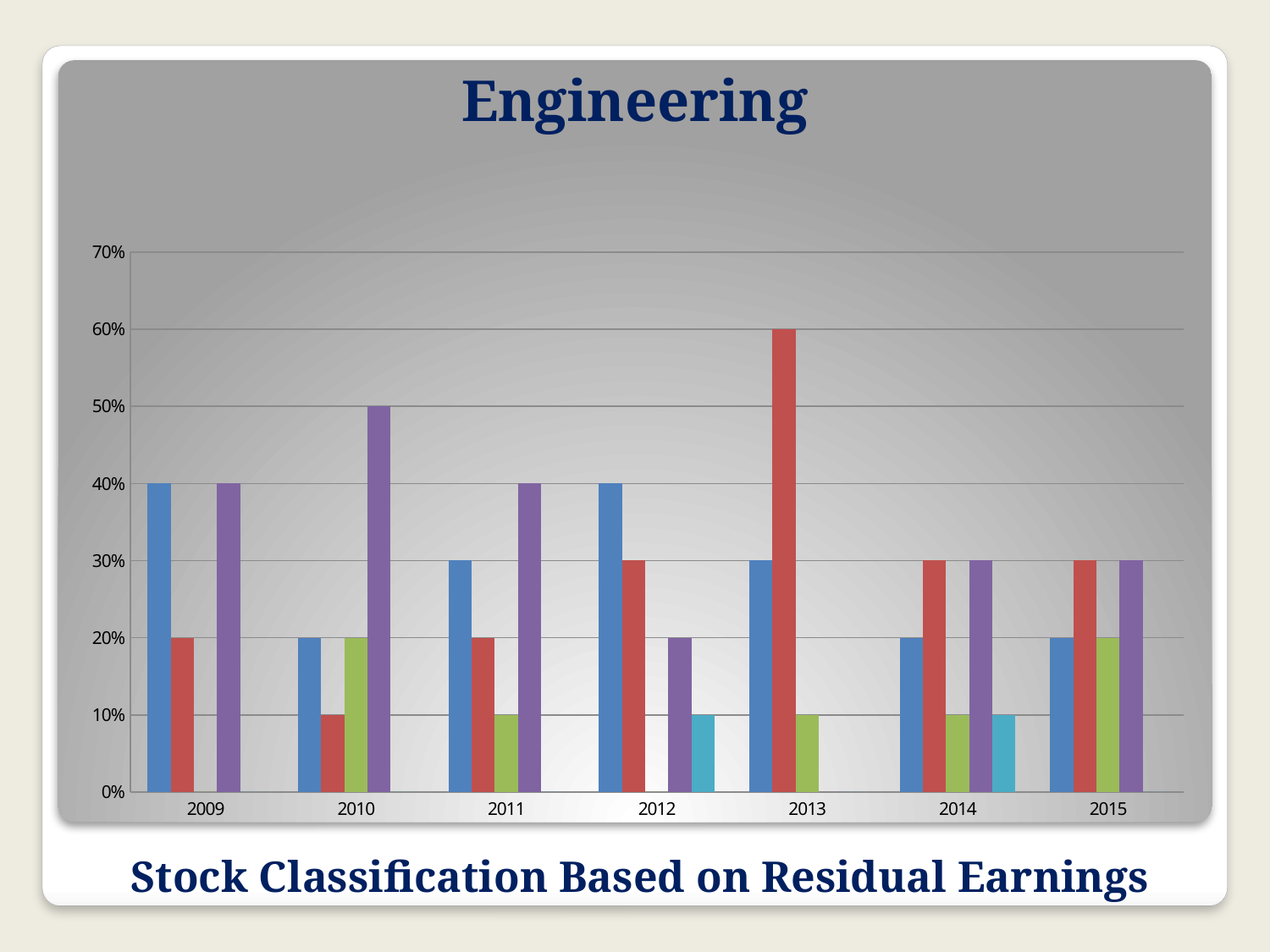
Is the value of the purple bar for 2010 greater or less than 40%? greater What is the value of the purple bar for 2010? 50% What kind of chart is shown on the slide? bar chart How many years are shown on the x axis of the chart? 7 What is the title of the chart? Engineering Which year has the tallest bar in the chart? 2013 What is the difference between the red bar for 2013 and the blue bar for 2013? 30% What is the value of the green bar for 2015? 20% What is the value of the blue bar for 2012? 40% What is the difference between the purple bar for 2009 and the red bar for 2009? 20% What is the value of the red bar for 2013? 60% Which is larger for 2011, the blue bar or the purple bar? purple bar